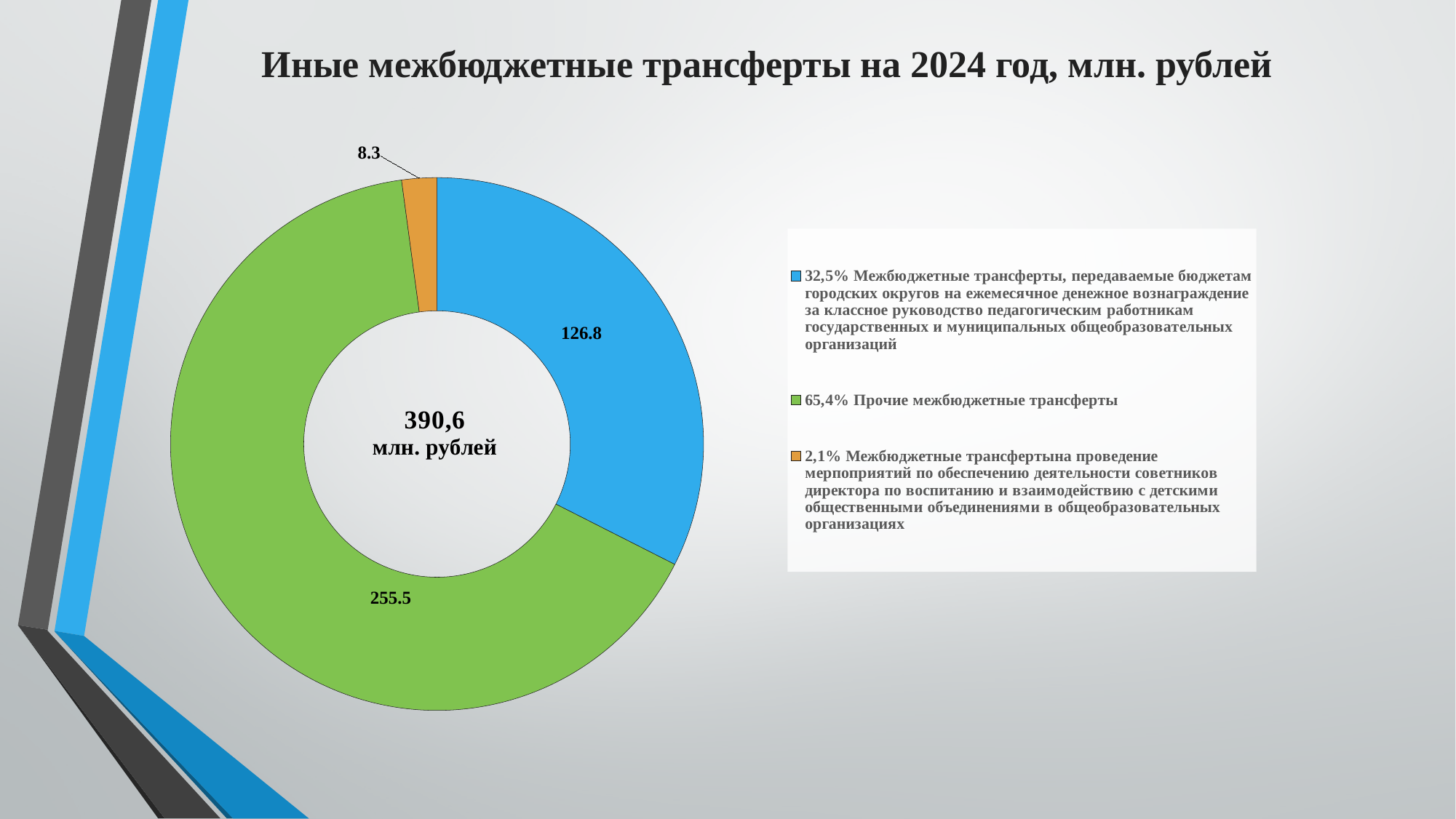
What type of chart is shown on the slide? Doughnut (pie) chart What is the difference between the value for "Прочие межбюджетные трансферты" and the value for the classroom leadership transfers (126.8)? 128.7 How many slices does the chart have? 3 What is the value for the slice "Межбюджетные трансферты, передаваемые бюджетам городских округов на ежемесячное денежное вознаграждение за классное руководство..."? 126.8 Which category has the largest slice? Прочие межбюджетные трансферты What total is shown in the centre of the doughnut chart? 390,6 млн. рублей What is the value for "Прочие межбюджетные трансферты"? 255.5 Which is larger: the slice for "Прочие межбюджетные трансферты" or the slice for the classroom leadership transfers? Прочие межбюджетные трансферты What is the value for the slice "Межбюджетные трансферты на проведение мероприятий по обеспечению деятельности советников директора по воспитанию..."? 8.3 What share of the total does the slice for classroom leadership payments ("за классное руководство") represent, according to the legend? 32,5% What share of the total does "Прочие межбюджетные трансферты" represent, according to the legend? 65,4%